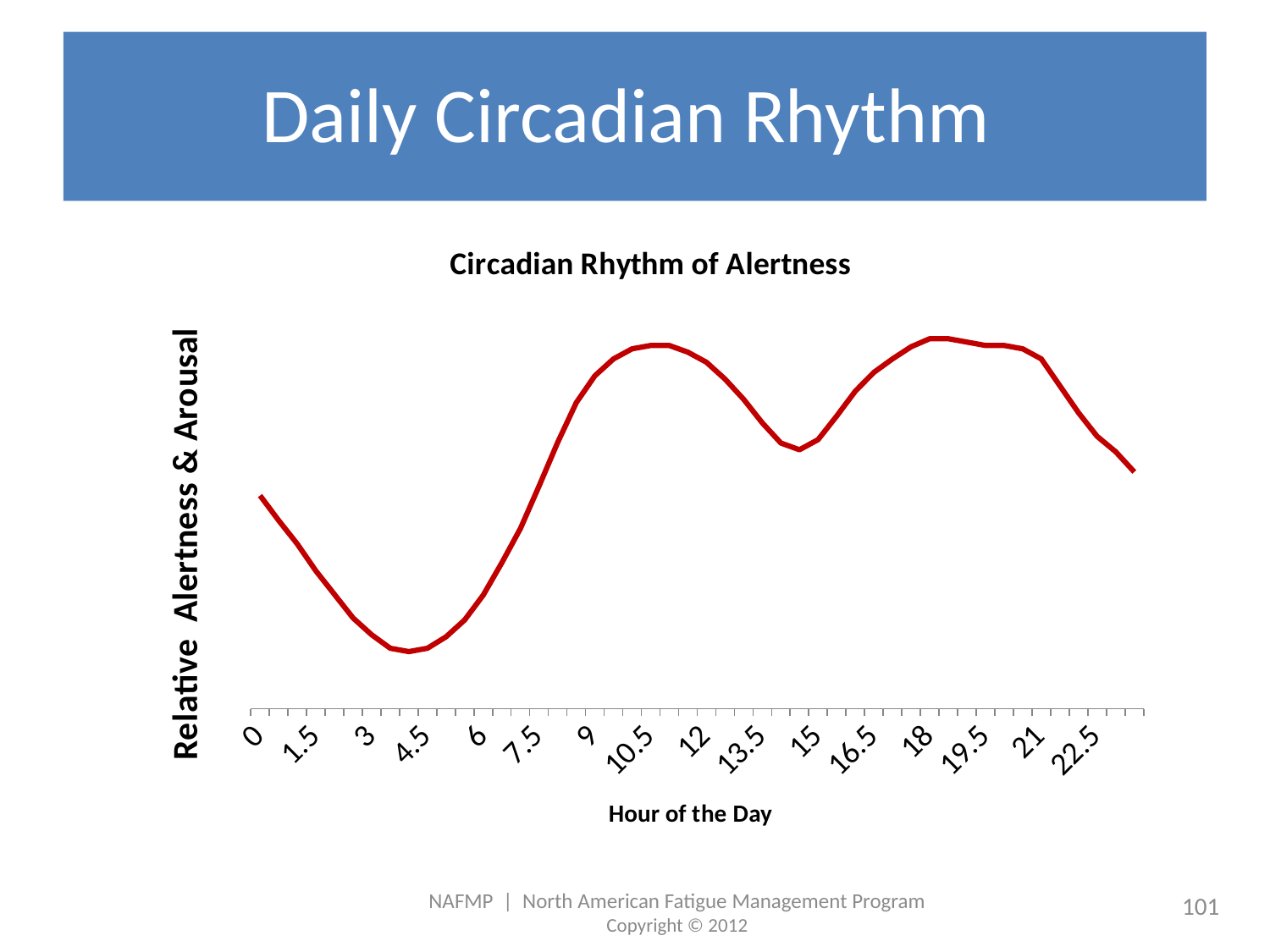
What kind of chart is shown on the slide? Line chart At which labelled hour of the day is relative alertness lowest? 4.5 Does relative alertness rise or fall between hour 21 and hour 22.5? Fall How many lines are plotted on the chart? 1 Does relative alertness rise or fall between hour 12 and hour 15? Fall What is the title of the chart? Circadian Rhythm of Alertness Which is higher, relative alertness at hour 3 or at hour 12? Hour 12 Does relative alertness rise or fall between hour 0 and hour 4.5? Fall What is the label of the x axis? Hour of the Day Which is higher, relative alertness at hour 15 or at hour 4.5? Hour 15 How many hour labels are shown along the x axis? 16